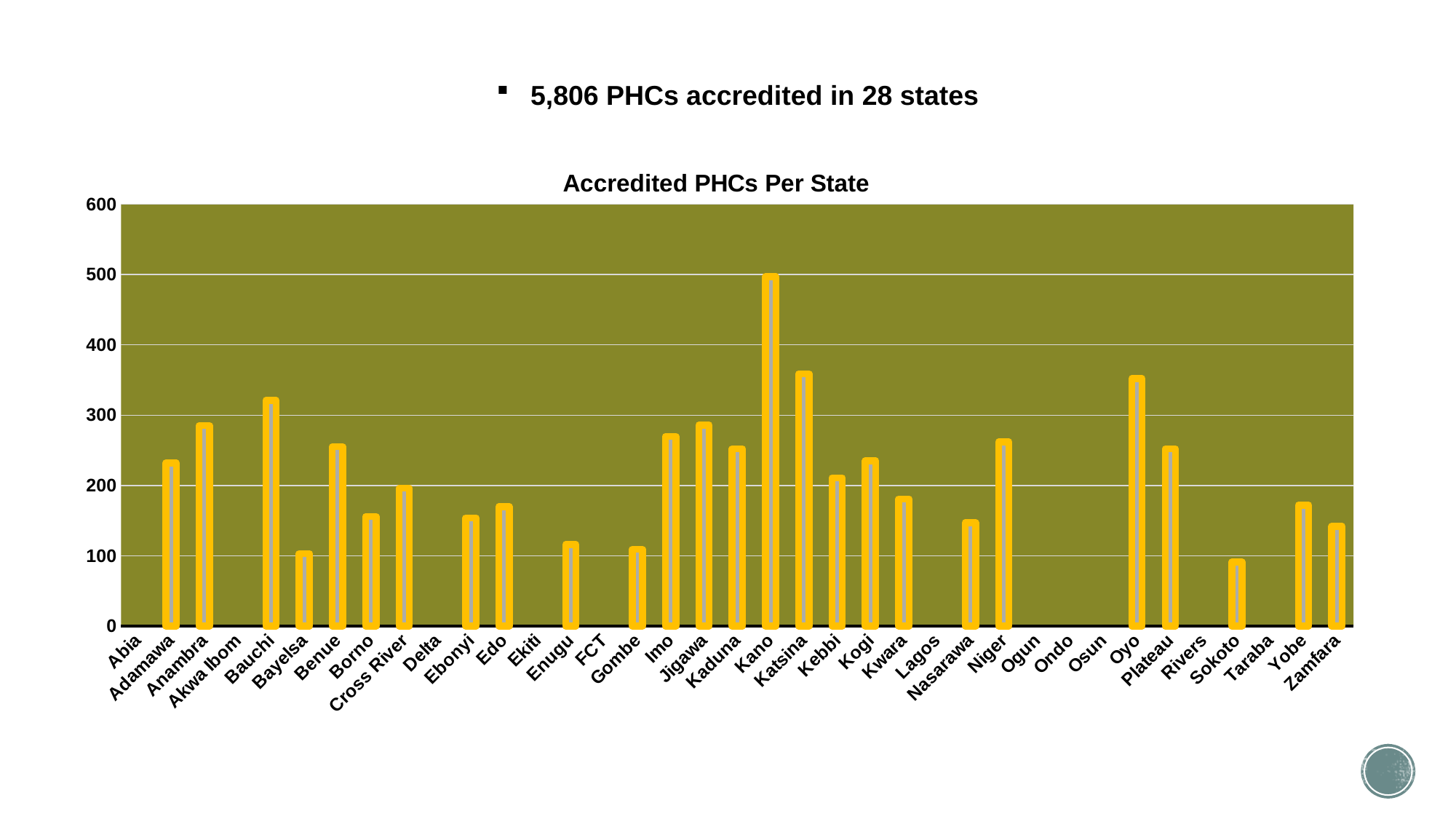
Which has a higher value, Kano or Katsina? Kano Is the value for Adamawa greater or less than 200? greater Which has a higher value, Bauchi or Anambra? Bauchi What is the title of the chart? Accredited PHCs Per State How many states are listed along the x axis of the chart? 37 According to the bullet text above the chart, how many PHCs were accredited and in how many states? 5,806 PHCs in 28 states What kind of chart is shown on the slide? bar chart Is the value for Kano greater or less than 400? greater Is the value for Bayelsa greater or less than 200? less Which state has the tallest bar in the chart? Kano